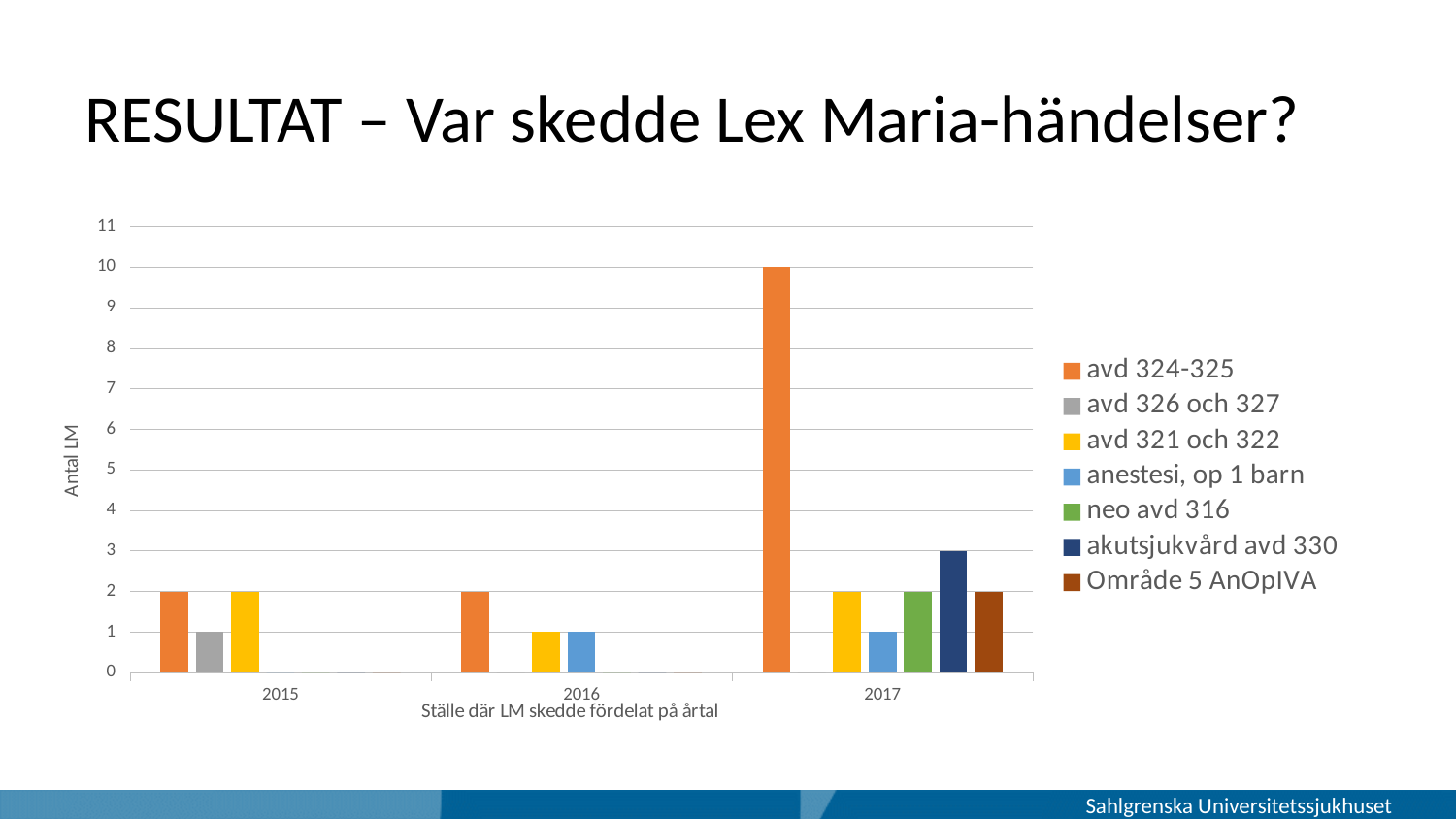
What is the value for akutsjukvård avd 330 in 2017? 3 What is the difference between avd 324-325 in 2017 and avd 324-325 in 2016? 8 Which series has the highest value in 2017? avd 324-325 How many series does the legend list? 7 Which is larger in 2017: akutsjukvård avd 330 or neo avd 316? akutsjukvård avd 330 Is the value for avd 324-325 in 2017 greater or less than 8? greater What is the value for avd 324-325 in 2017? 10 How many years are shown on the x axis? 3 What is the value for avd 326 och 327 in 2015? 1 What is the label of the y axis? Antal LM What kind of chart is shown on the slide? bar chart Does the value for avd 324-325 rise or fall from 2016 to 2017? rise